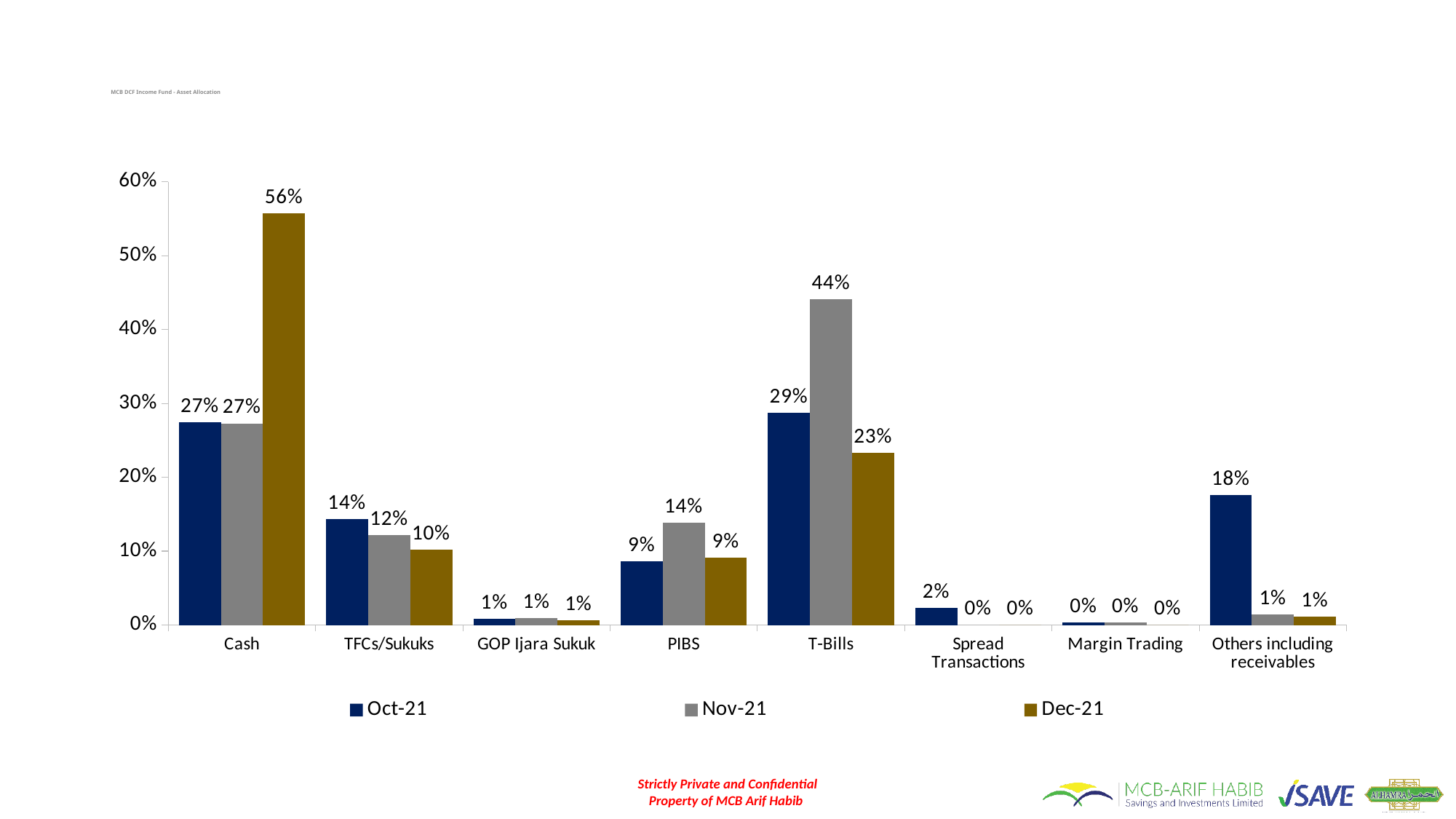
Which is larger for PIBS, the Oct-21 value or the Nov-21 value? Nov-21 What is the difference between the Dec-21 and Oct-21 values for Cash? 29% How many categories are shown on the x axis? 8 What kind of chart is shown on the slide? Bar chart Is the Dec-21 value for Cash greater or less than 50%? greater What is the Nov-21 value for T-Bills? 44% What is the Oct-21 value for Others including receivables? 18% How many series does the legend list? 3 Which category has the highest Nov-21 value? T-Bills What is the difference between the Nov-21 and Dec-21 values for T-Bills? 21% Which category has the highest Dec-21 value? Cash What is the Dec-21 value for Cash? 56%